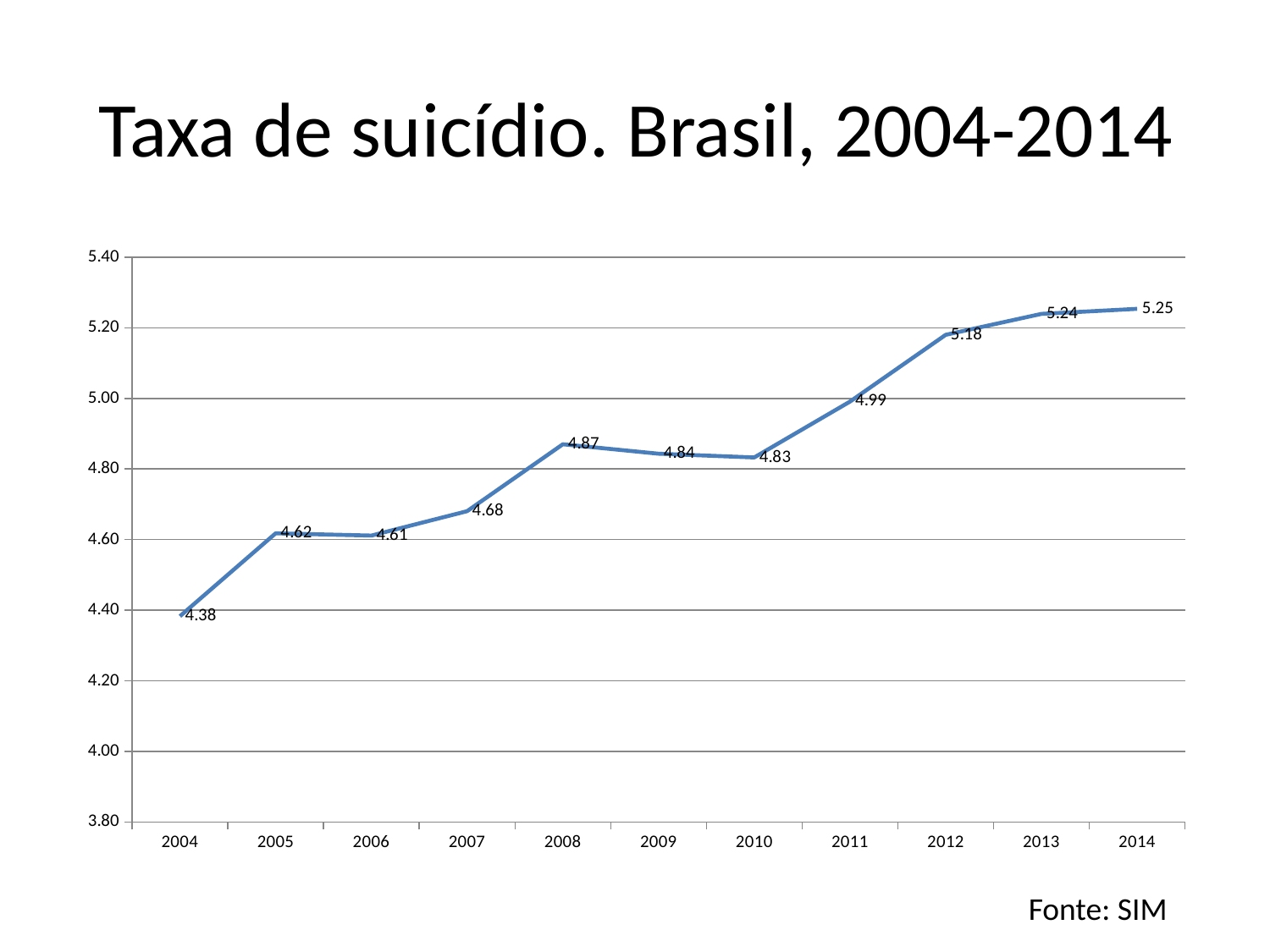
What is the value shown for 2012? 5.18 Which is larger, the value for 2008 or the value for 2010? 2008 What kind of chart is shown on the slide? Line chart Which year has the highest value on the chart? 2014 Is the value for 2011 greater or less than 4.80? greater What is the difference between the values for 2014 and 2004? 0.87 What is the value shown for 2008? 4.87 Do the values generally rise or fall from 2004 to 2014? Rise How many years are plotted on the x axis? 11 What is the suicide rate value shown for 2004? 4.38 Which year has the lowest value on the chart? 2004 What is the title of the chart on the slide? Taxa de suicídio. Brasil, 2004-2014